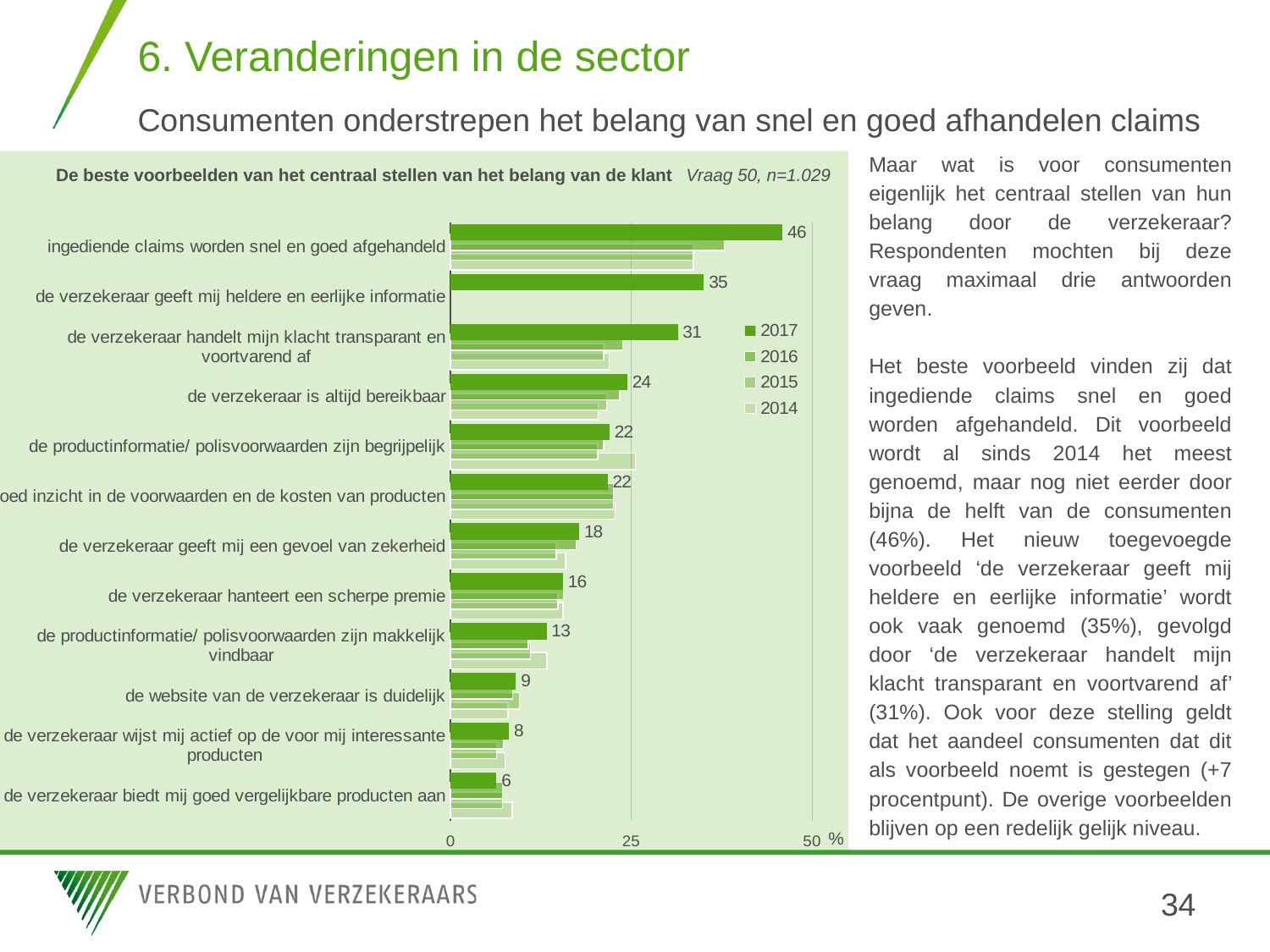
What is the difference between the 2017 values for 'de verzekeraar handelt mijn klacht transparant en voortvarend af' and 'de verzekeraar is altijd bereikbaar'? 7 What kind of chart is shown on the slide? bar chart Is the 2016 value for 'ingediende claims worden snel en goed afgehandeld' greater or less than 25? greater Which category has the lowest 2017 value? de verzekeraar biedt mij goed vergelijkbare producten aan How many categories are shown in the chart? 12 How many series does the legend list? 4 What is the difference between the 2017 values for 'ingediende claims worden snel en goed afgehandeld' and 'de verzekeraar geeft mij heldere en eerlijke informatie'? 11 What is the 2017 value for 'ingediende claims worden snel en goed afgehandeld'? 46 Which has the larger 2017 value: 'de verzekeraar geeft mij een gevoel van zekerheid' or 'de verzekeraar hanteert een scherpe premie'? de verzekeraar geeft mij een gevoel van zekerheid What is the 2017 value for 'de verzekeraar geeft mij heldere en eerlijke informatie'? 35 Which category has the highest 2017 value? ingediende claims worden snel en goed afgehandeld What is the 2017 value for 'de website van de verzekeraar is duidelijk'? 9